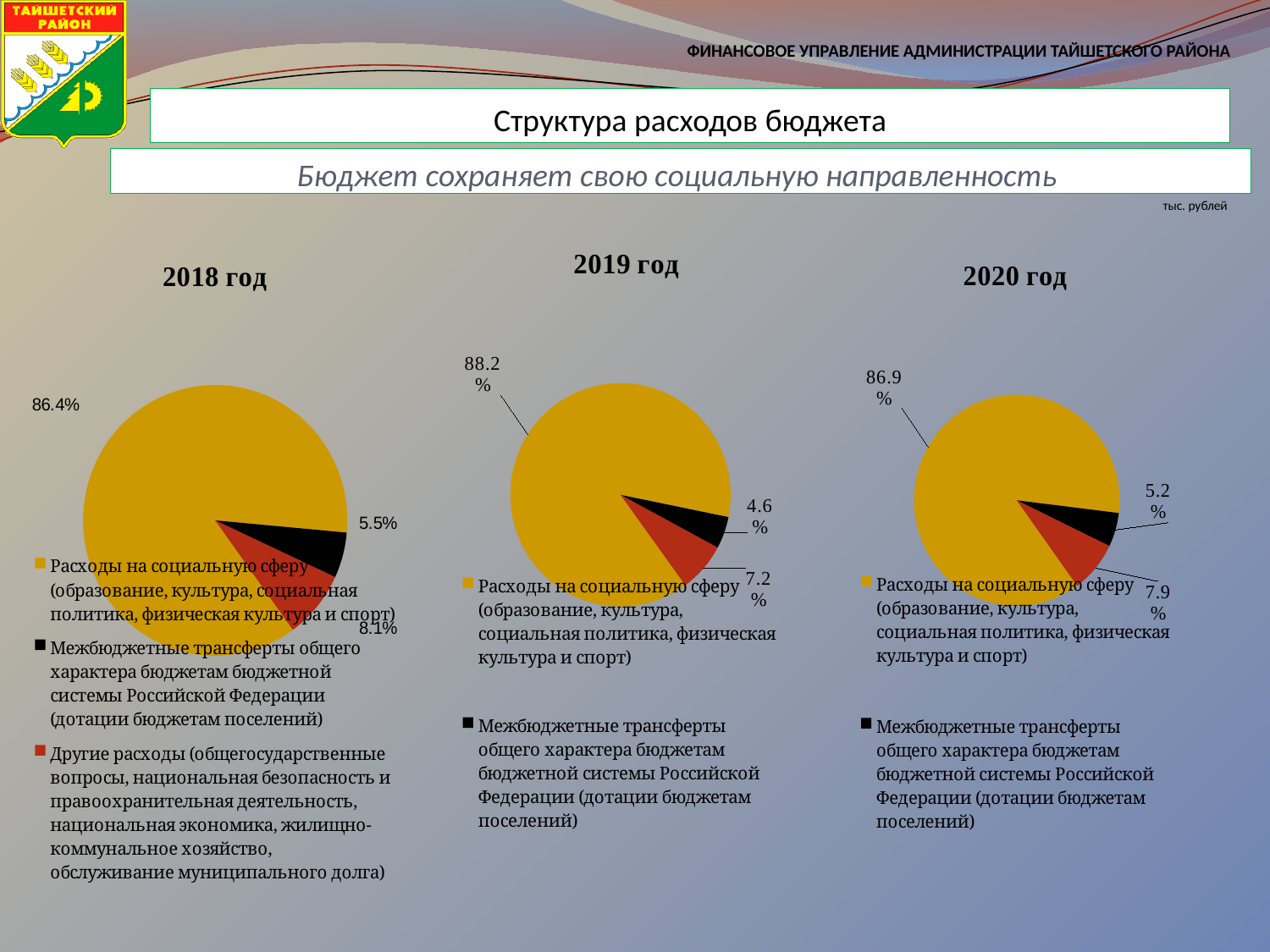
In the 2020 год pie chart, what value is shown for the red slice? 7.9% How many legend entries are listed under the 2018 год pie chart? 3 How many slices does the 2020 год pie chart have? 3 In the 2018 год pie chart, what share is shown for Межбюджетные трансферты общего характера? 5.5% In the 2020 год pie chart, what is the smallest slice's value? 5.2% In the 2019 год pie chart, what is the difference between the largest slice (88.2%) and the smallest slice (4.6%)? 83.6% In the 2018 год pie chart, what share is shown for Расходы на социальную сферу? 86.4% What colour is the slice for Расходы на социальную сферу in the pie charts? yellow Which year's pie chart shows a larger share for Расходы на социальную сферу: 2019 год or 2020 год? 2019 год In the 2019 год pie chart, what is the largest slice's value? 88.2% What type of chart is used for 2018 год? pie chart In the 2018 год pie chart, what share is shown for Другие расходы? 8.1%